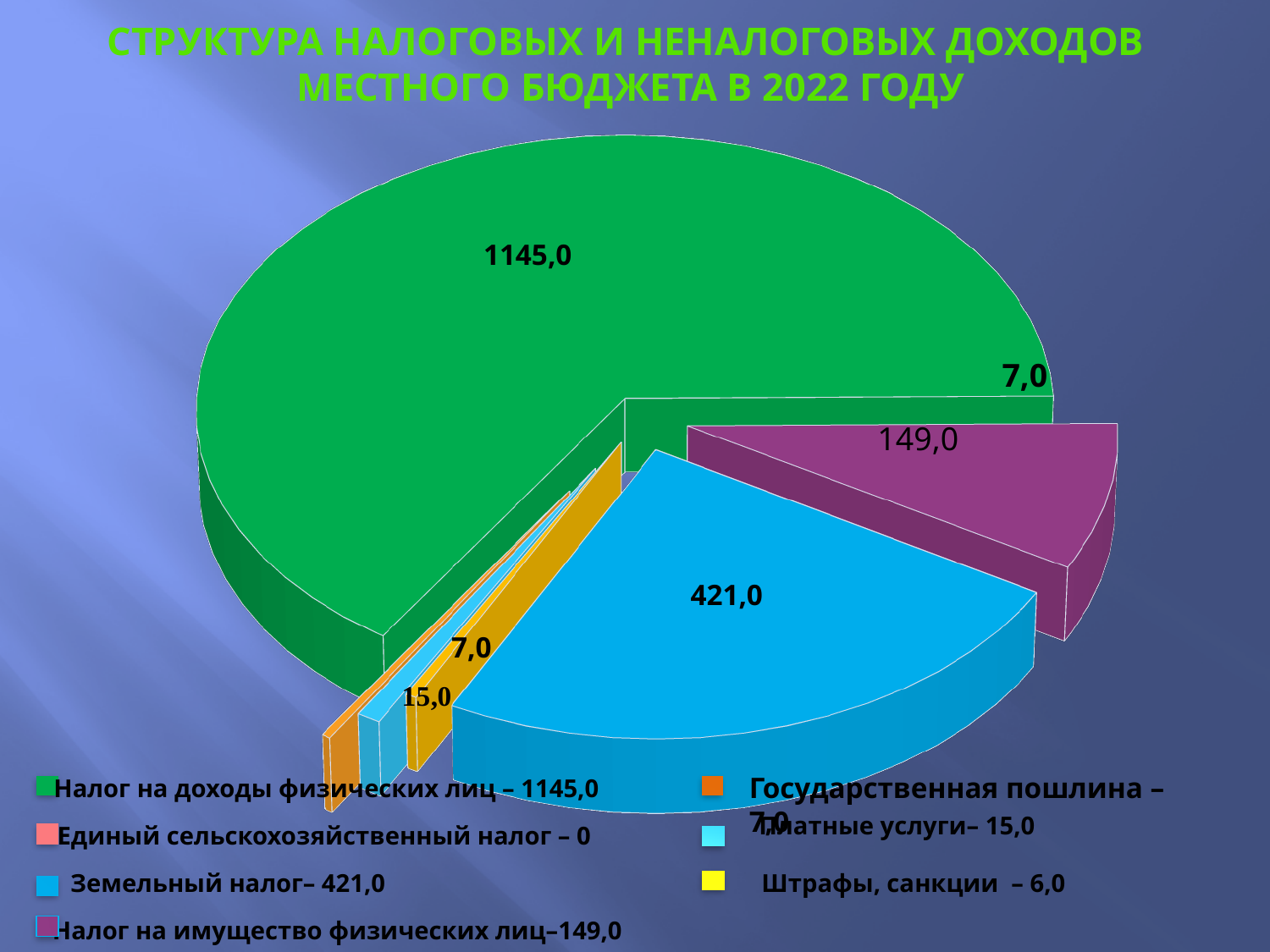
What is the difference between Налог на доходы физических лиц and Земельный налог? 724,0 Which category has the smallest value? Единый сельскохозяйственный налог What is the value for Земельный налог? 421,0 What kind of chart is shown on the slide? pie chart What is the value for Налог на доходы физических лиц? 1145,0 What is the title of the chart? СТРУКТУРА НАЛОГОВЫХ И НЕНАЛОГОВЫХ ДОХОДОВ МЕСТНОГО БЮДЖЕТА В 2022 ГОДУ Which category has the largest value? Налог на доходы физических лиц Which is larger, Налог на имущество физических лиц or Платные услуги? Налог на имущество физических лиц How many categories does the legend list? 7 What is the value for Штрафы, санкции? 6,0 What is the value for Платные услуги? 15,0 What is the value for Налог на имущество физических лиц? 149,0